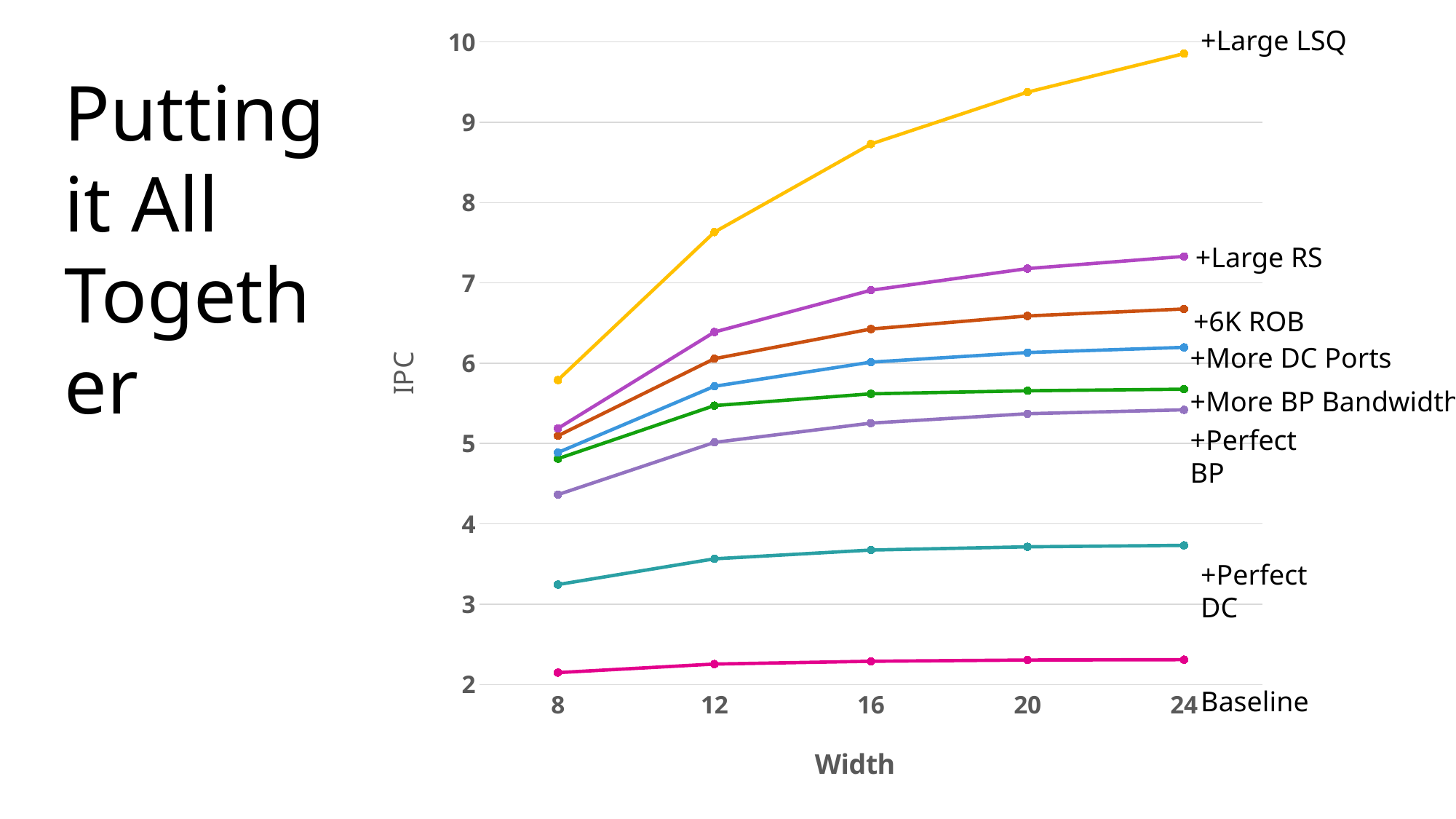
How many series are labelled on the chart? 8 How many width values are plotted along the x axis? 5 Does the IPC for +Large LSQ rise or fall as width increases from 8 to 24? rise Is the IPC for +Perfect DC at width 24 greater or less than 4? less At width 12, which has the higher IPC: +6K ROB or +Perfect BP? +6K ROB What is the label of the x axis? Width Which series has the lowest IPC at width 24? Baseline Is the IPC for +Large LSQ at width 24 greater or less than 9? greater Which series has the highest IPC at width 24? +Large LSQ Is the IPC for +Large RS at width 16 greater or less than 6? greater What kind of chart is shown on the slide? line chart